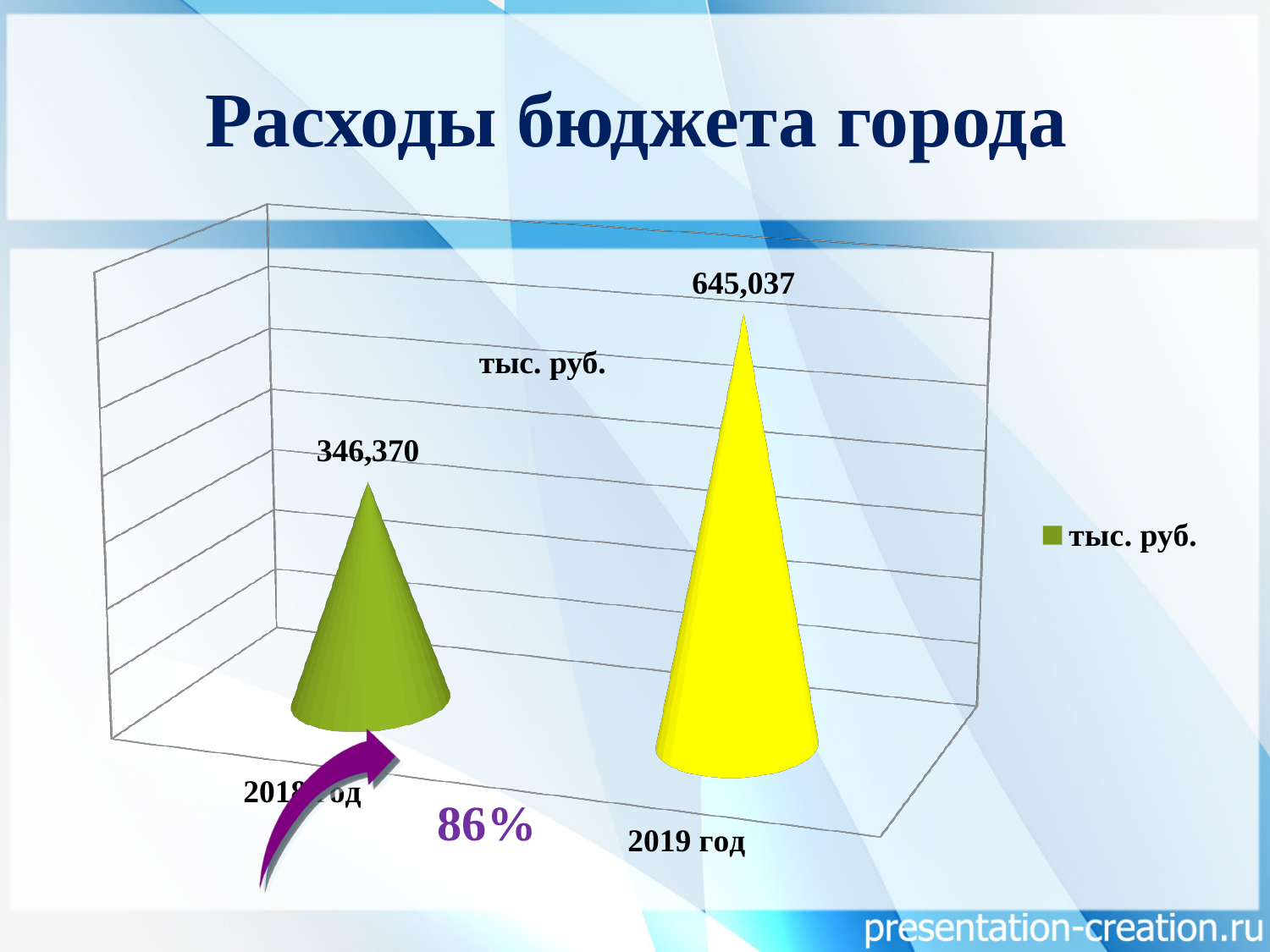
What kind of chart is shown on the slide? bar chart Do the values rise or fall from the left category to the right category? rise Which category has the highest value? 2019 год Which is larger, the value for 2019 год or the value for the green cone on the left? 2019 год What series name is shown in the chart legend? тыс. руб. What is the difference between the value for 2019 год and the value for the green cone on the left? 298,667 What is the value shown for the green cone on the left? 346,370 What is the title of the slide? Расходы бюджета города How many series does the legend list? 1 How many categories are plotted in the chart? 2 Which cone shows the lowest value, the green one on the left or the yellow one on the right? the green one on the left What is the value shown for 2019 год? 645,037